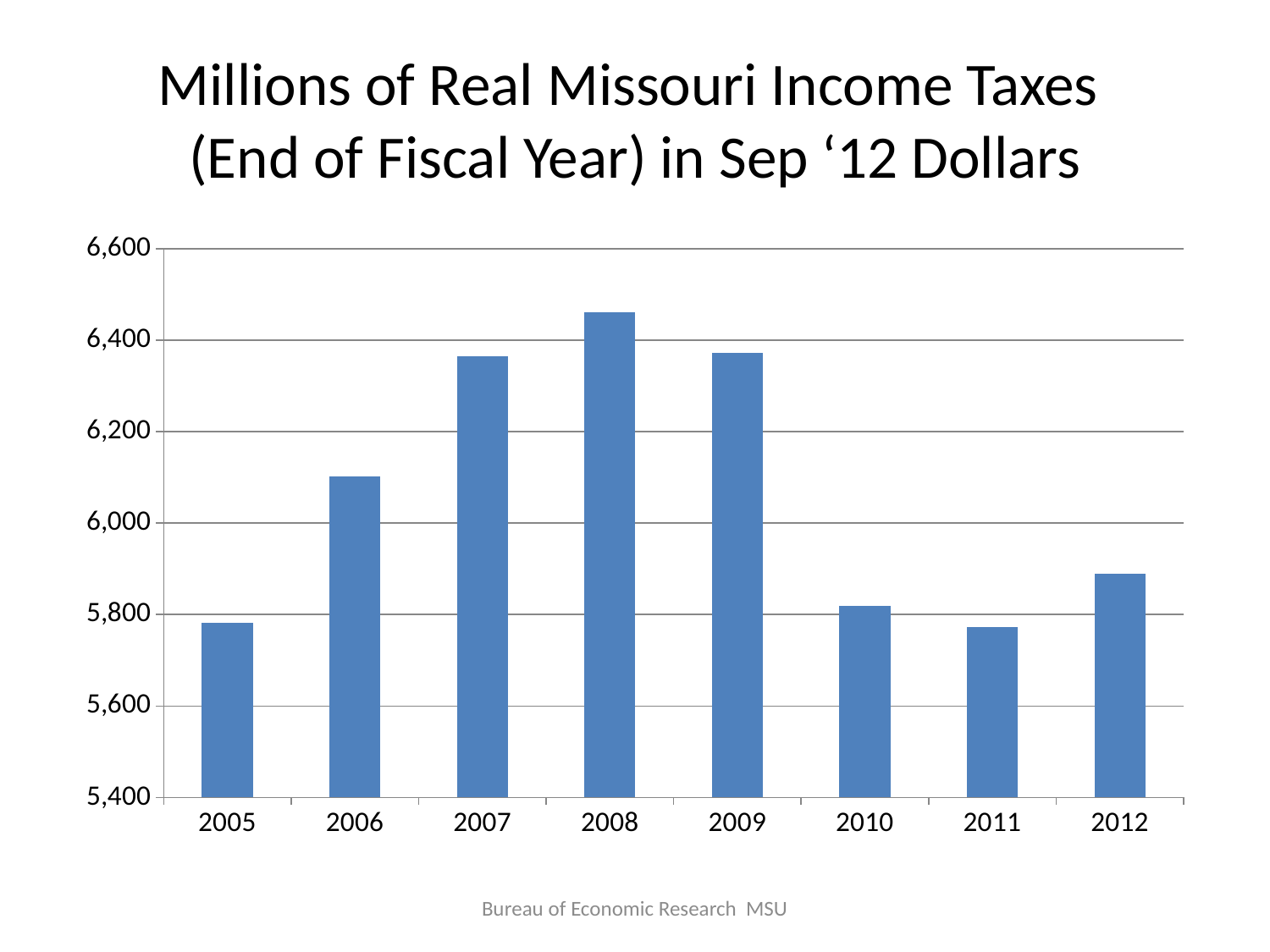
How many years are plotted on the chart? 8 Do the values rise or fall from 2009 to 2010? fall Which is larger, the value for 2010 or the value for 2012? 2012 What kind of chart is shown on the slide? bar chart Which is larger, the value for 2006 or the value for 2012? 2006 Is the value for 2011 greater or less than 5,800? less Is the value for 2012 greater or less than 6,000? less Is the value for 2006 greater or less than 6,000? greater What is the title of the chart? Millions of Real Missouri Income Taxes (End of Fiscal Year) in Sep '12 Dollars Which year has the highest value? 2008